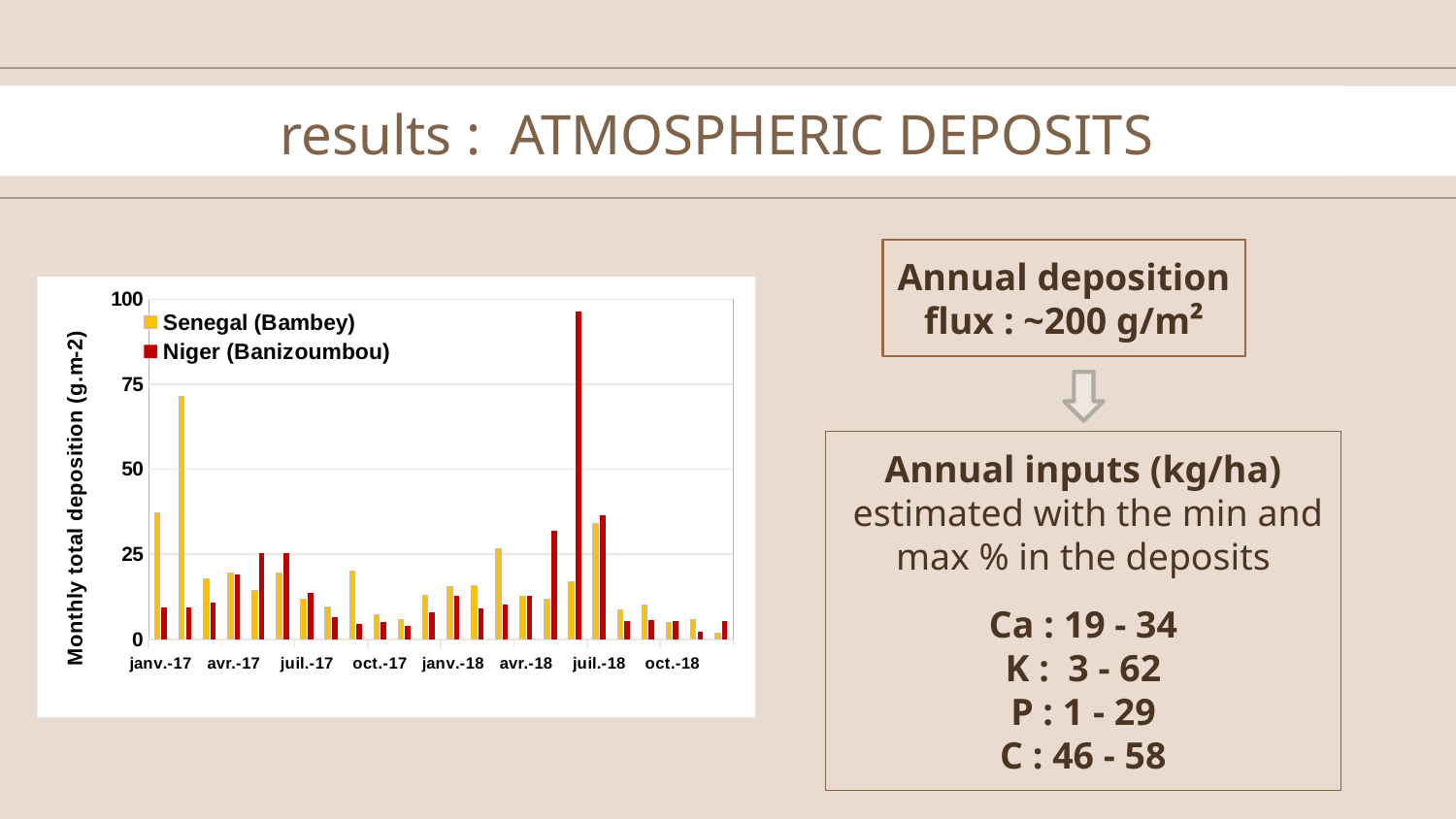
Is the tallest Niger (Banizoumbou) bar greater or less than 75? greater Which two series are listed in the chart legend? Senegal (Bambey) and Niger (Banizoumbou) Which series has the tallest bar on the chart? Niger (Banizoumbou) What kind of chart is shown on the slide? bar chart How many month labels are shown on the x axis of the chart? 8 What is the y-axis title of the chart? Monthly total deposition (g.m-2) At janv.-17, which series has the larger value, Senegal (Bambey) or Niger (Banizoumbou)? Senegal (Bambey) How many series does the chart legend list? 2 Is the value for Niger (Banizoumbou) at janv.-17 greater or less than 25? less Is the tallest Senegal (Bambey) bar greater or less than 75? less